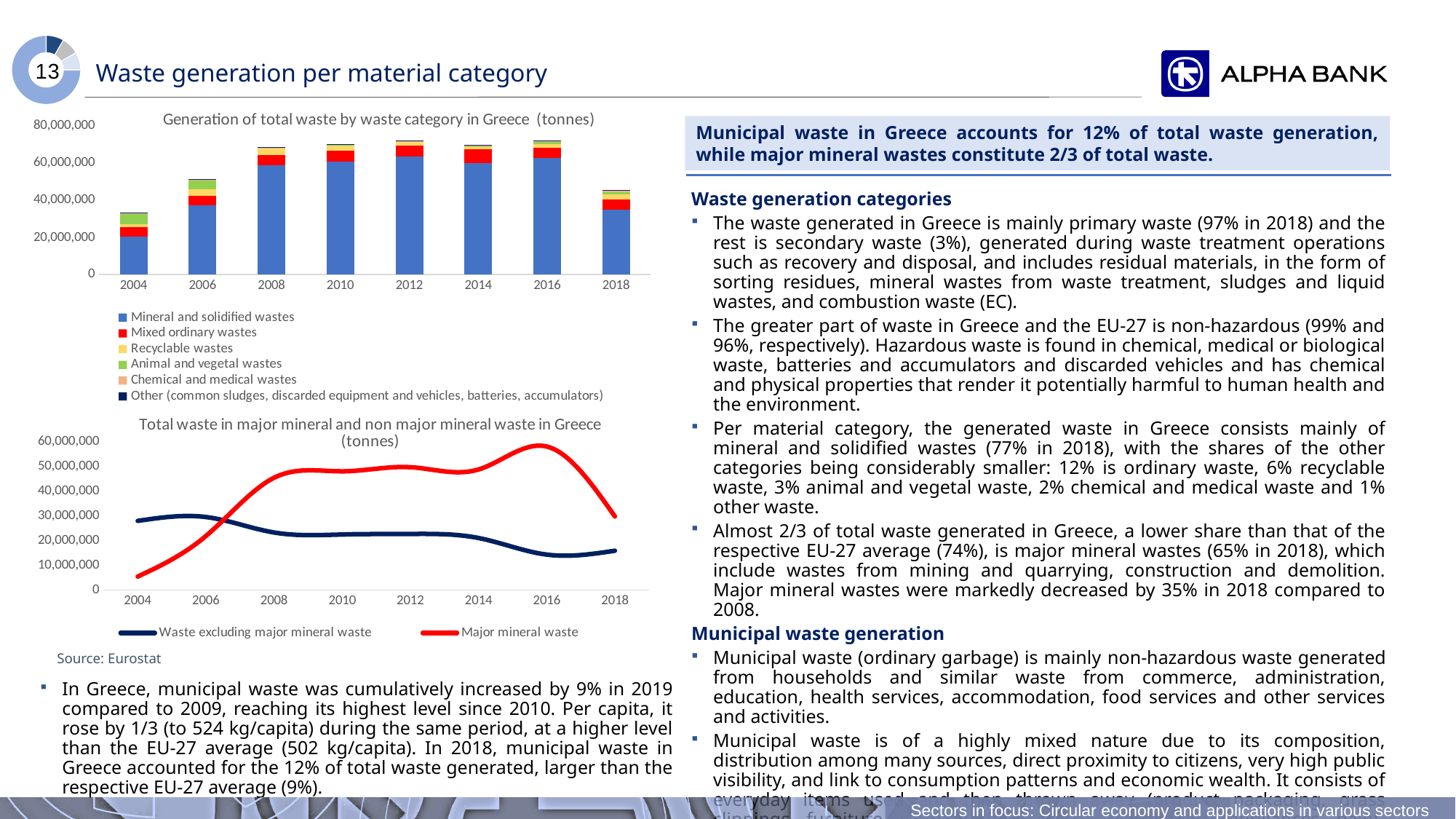
What type of chart is the top chart titled 'Generation of total waste by waste category in Greece (tonnes)'? Stacked bar chart In the top chart, is the total waste generated in 2004 greater or less than 40,000,000 tonnes? less What type of chart is the bottom chart titled 'Total waste in major mineral and non major mineral waste in Greece (tonnes)'? Line chart In the top chart, is the total waste generated in 2016 greater or less than 60,000,000 tonnes? greater How many series does the legend of the top chart list? 6 In the bottom chart, which series has the larger value in 2004: waste excluding major mineral waste or major mineral waste? Waste excluding major mineral waste In the bottom chart, is the value for major mineral waste in 2016 greater or less than 50,000,000 tonnes? greater In the bottom chart, which year shows the highest value for major mineral waste? 2016 How many years are shown on the x axis of the top chart? 8 How many series does the legend of the bottom chart list? 2 In the top chart, which year has the lowest total waste generation? 2004 In the bottom chart, does the major mineral waste line rise or fall between 2016 and 2018? Fall